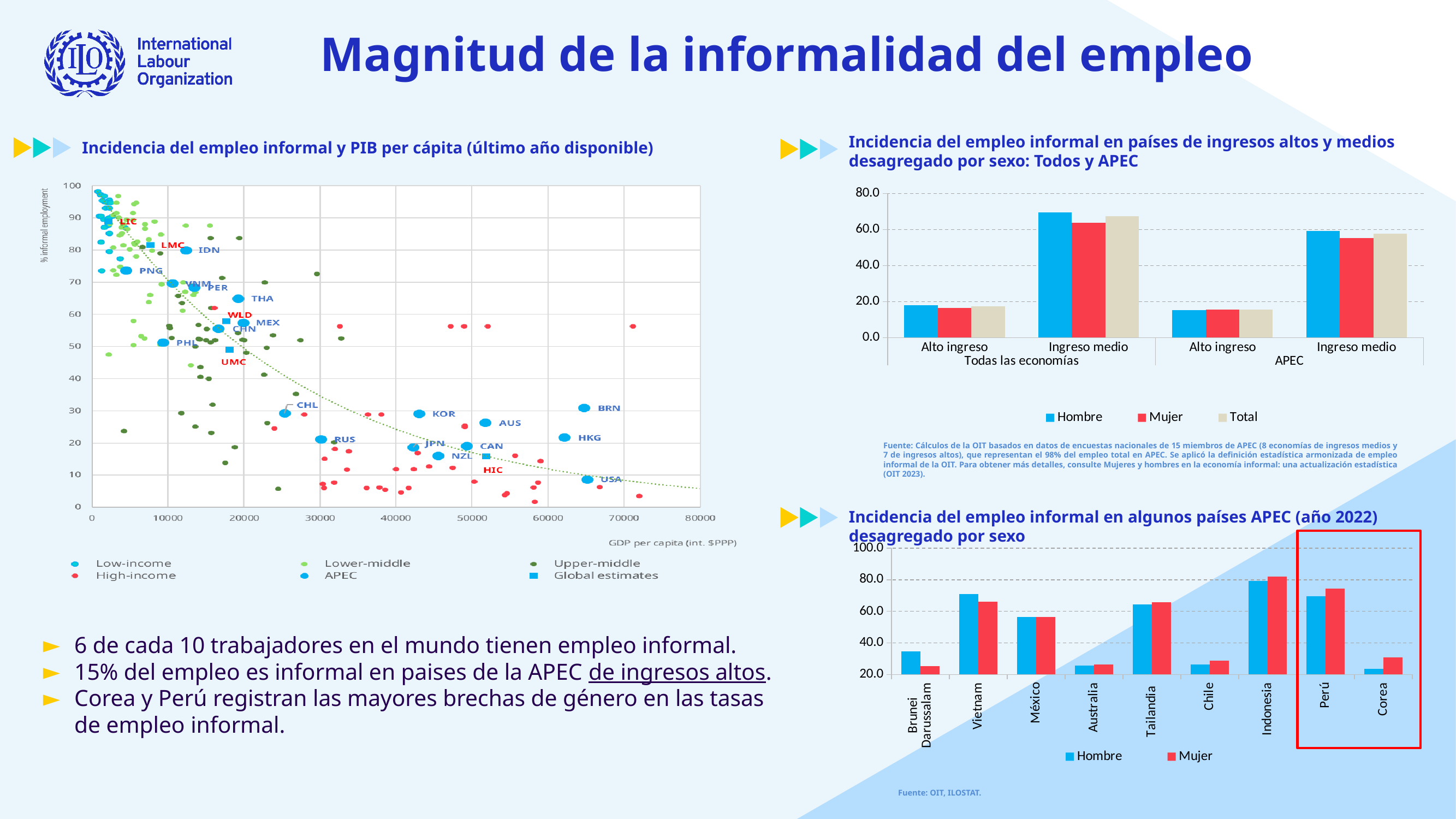
In the chart 'Incidencia del empleo informal y PIB per cápita', is the value for USA greater or less than 20? less In the chart 'Incidencia del empleo informal en algunos países APEC (año 2022) desagregado por sexo', which country has the highest Hombre value? Indonesia What kind of chart is the chart titled 'Incidencia del empleo informal y PIB per cápita (último año disponible)'? scatter plot In the chart 'Incidencia del empleo informal y PIB per cápita', how many entries does the legend list? 6 In the chart 'Incidencia del empleo informal en países de ingresos altos y medios desagregado por sexo: Todos y APEC', is the Hombre value for Ingreso medio under Todas las economías greater or less than 60? greater What kind of chart is 'Incidencia del empleo informal en algunos países APEC (año 2022) desagregado por sexo'? bar chart In the chart 'Incidencia del empleo informal en países de ingresos altos y medios desagregado por sexo: Todos y APEC', is the Mujer value for Alto ingreso under APEC greater or less than 20? less In the chart 'Incidencia del empleo informal en países de ingresos altos y medios desagregado por sexo: Todos y APEC', which is larger for Ingreso medio under Todas las economías, Hombre or Mujer? Hombre In the chart 'Incidencia del empleo informal en algunos países APEC (año 2022) desagregado por sexo', how many countries are shown? 9 In the chart 'Incidencia del empleo informal en países de ingresos altos y medios desagregado por sexo: Todos y APEC', how many series does the legend list? 3 In the chart 'Incidencia del empleo informal en algunos países APEC (año 2022) desagregado por sexo', which is larger for Corea, Hombre or Mujer? Mujer